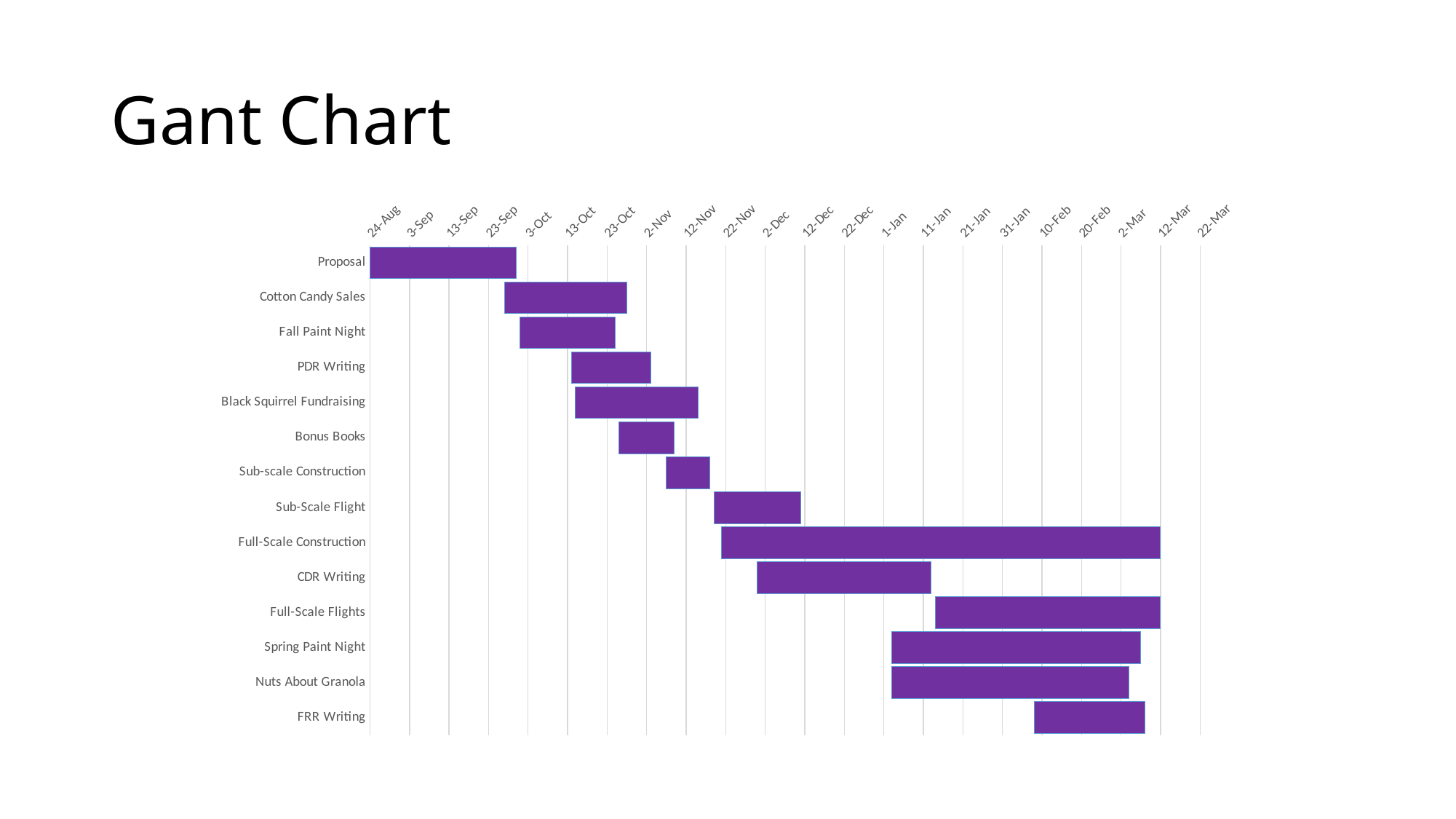
How many tasks are listed on the vertical axis of the chart? 14 Does the Proposal bar end before or after 23-Sep? after What is the title of the slide? Gant Chart Does the Sub-Scale Flight bar start before or after 12-Nov? after What kind of chart is shown on the slide? Bar chart (Gantt chart) Which task has the longest bar in the chart? Full-Scale Construction Which task starts earliest in the chart? Proposal Does the FRR Writing bar start before or after 31-Jan? after Which bar is longer, Cotton Candy Sales or Fall Paint Night? Cotton Candy Sales What colour are the bars in the chart? Purple Which task has the shortest bar in the chart? Sub-scale Construction Which bar is longer, Full-Scale Construction or CDR Writing? Full-Scale Construction